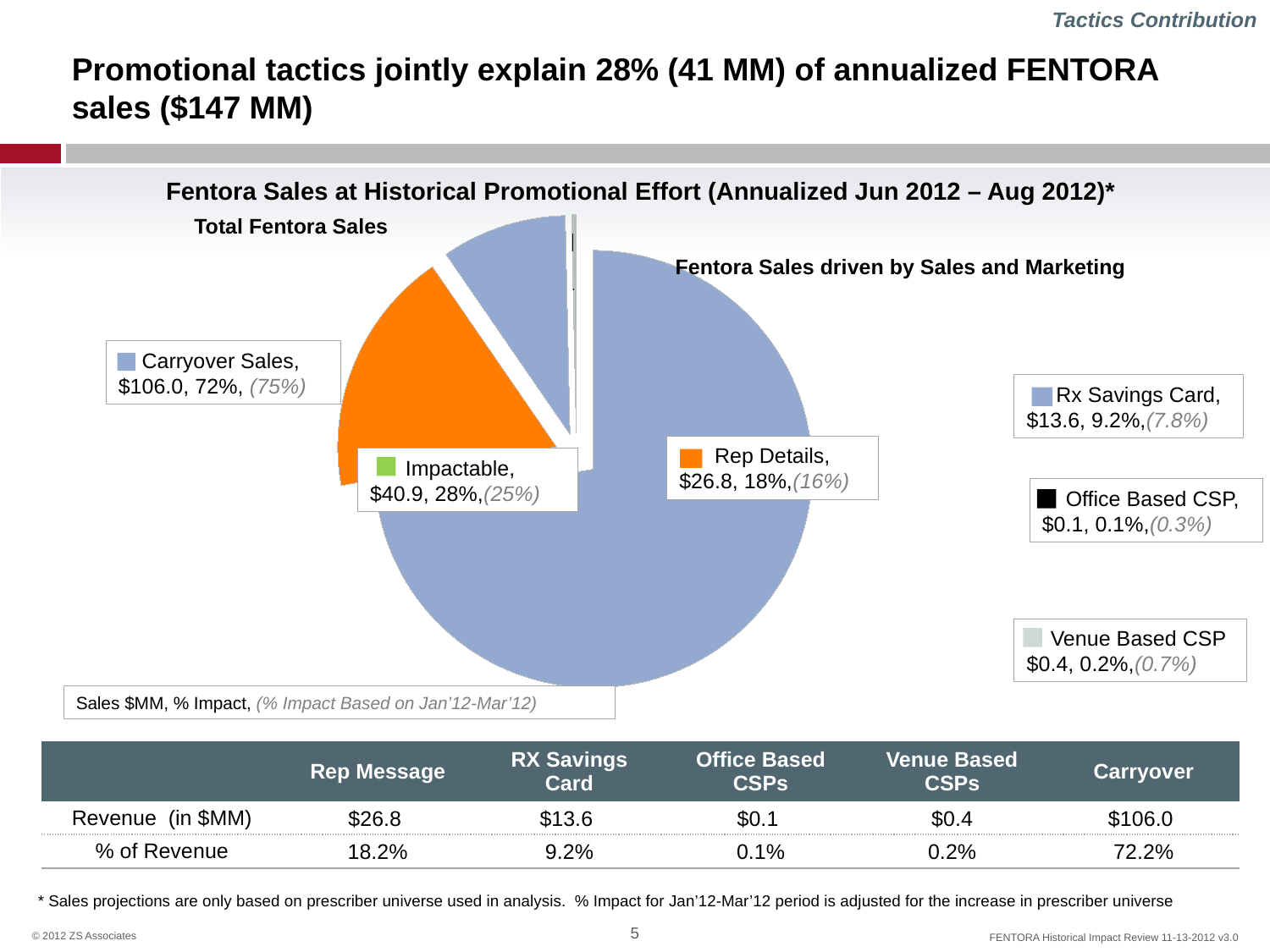
Which has higher sales in the pie chart, Venue Based CSP or Office Based CSP? Venue Based CSP What is the sales value shown for Carryover Sales in the pie chart? $106.0 What is the difference in sales between Carryover Sales and Impactable in the pie chart? $65.1 What is the difference in sales between Rep Details and Rx Savings Card in the pie chart? $13.2 What is the sales value shown for Office Based CSP in the pie chart? $0.1 What percentage of sales is attributed to Rep Details in the pie chart? 18% What share of total Fentora sales is labeled as Impactable in the pie chart? 28% Which category has the smallest slice in the pie chart? Office Based CSP What is the title of the pie chart? Fentora Sales at Historical Promotional Effort (Annualized Jun 2012 – Aug 2012)* Which category has the largest slice in the pie chart? Carryover Sales What kind of chart is shown on the slide? pie chart What is the sales value shown for Rx Savings Card in the pie chart? $13.6